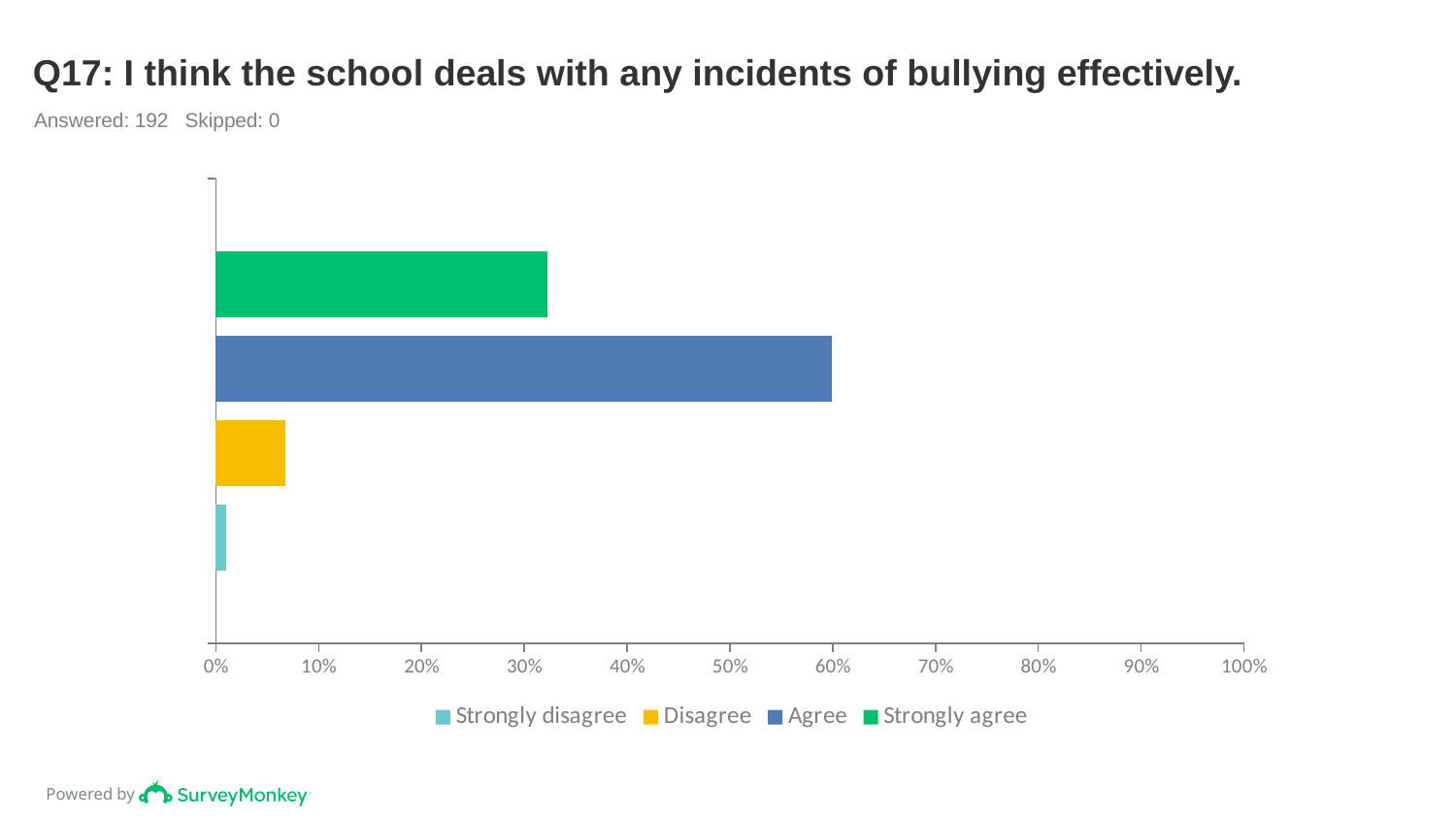
What kind of chart is shown on the slide? bar chart Is the value for Agree greater or less than 50%? greater How many respondents answered this question according to the slide? 192 Which response option has the highest value? Agree Which is larger, the value for Disagree or the value for Strongly disagree? Disagree What is the title of the chart? Q17: I think the school deals with any incidents of bullying effectively. Is the value for Disagree greater or less than 10%? less How many bars are plotted in the chart? 4 Is the value for Strongly agree greater or less than 30%? greater Which response option has the lowest value? Strongly disagree Which is larger, the value for Agree or the value for Strongly agree? Agree How many series does the legend list? 4